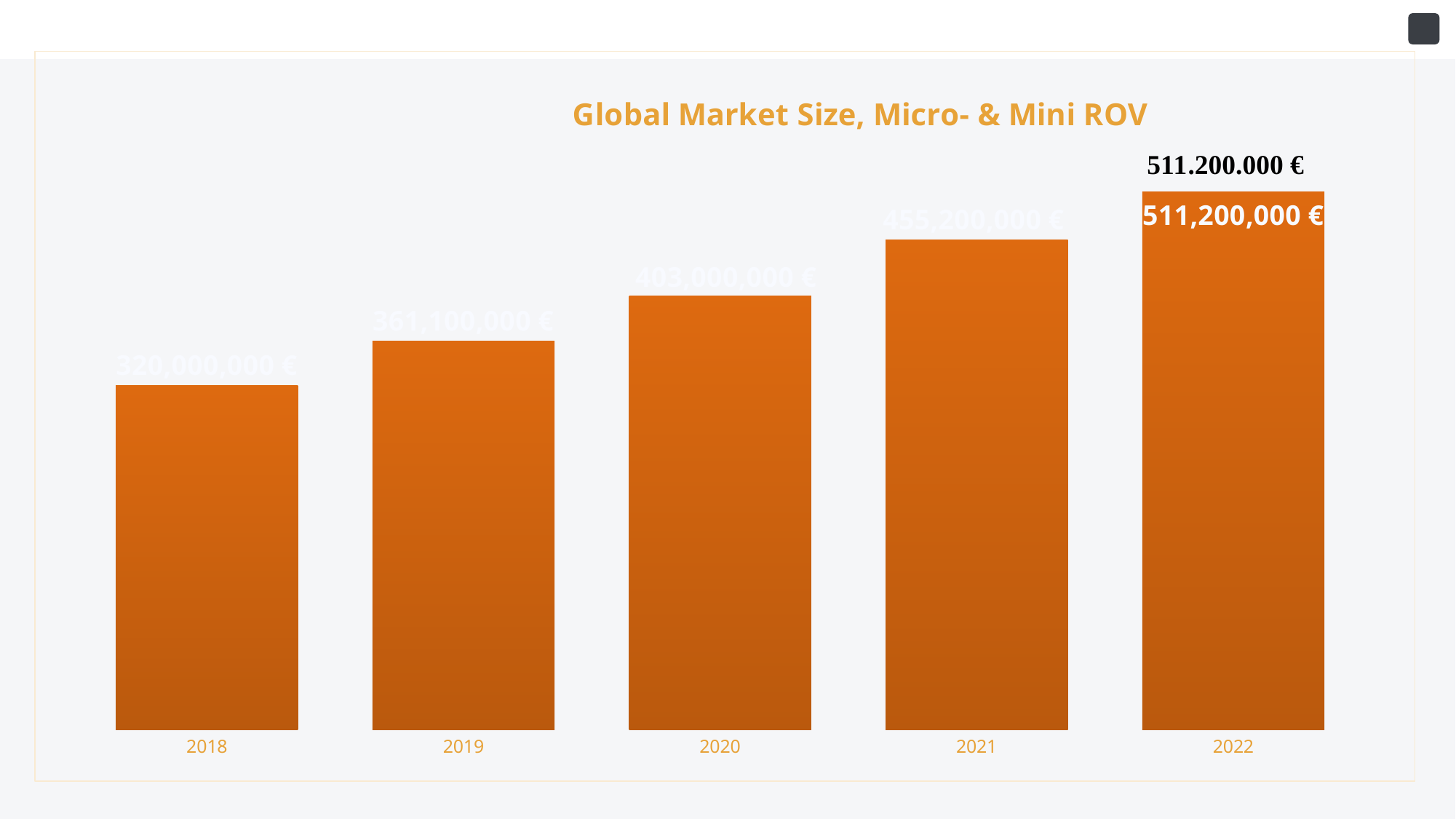
What is the value for 2019? 361,100,000 € What is the value for 2022? 511,200,000 € Which is larger, the value for 2019 or the value for 2020? 2020 What is the difference between the values for 2021 and 2020? 52,200,000 € What is the value for 2020? 403,000,000 € What is the value for 2021? 455,200,000 € How many years are shown on the x axis? 5 Which year has the lowest value? 2018 What is the difference between the values for 2022 and 2018? 191,200,000 € What is the value for 2018? 320,000,000 € Which year has the highest value? 2022 What kind of chart is shown? Bar chart